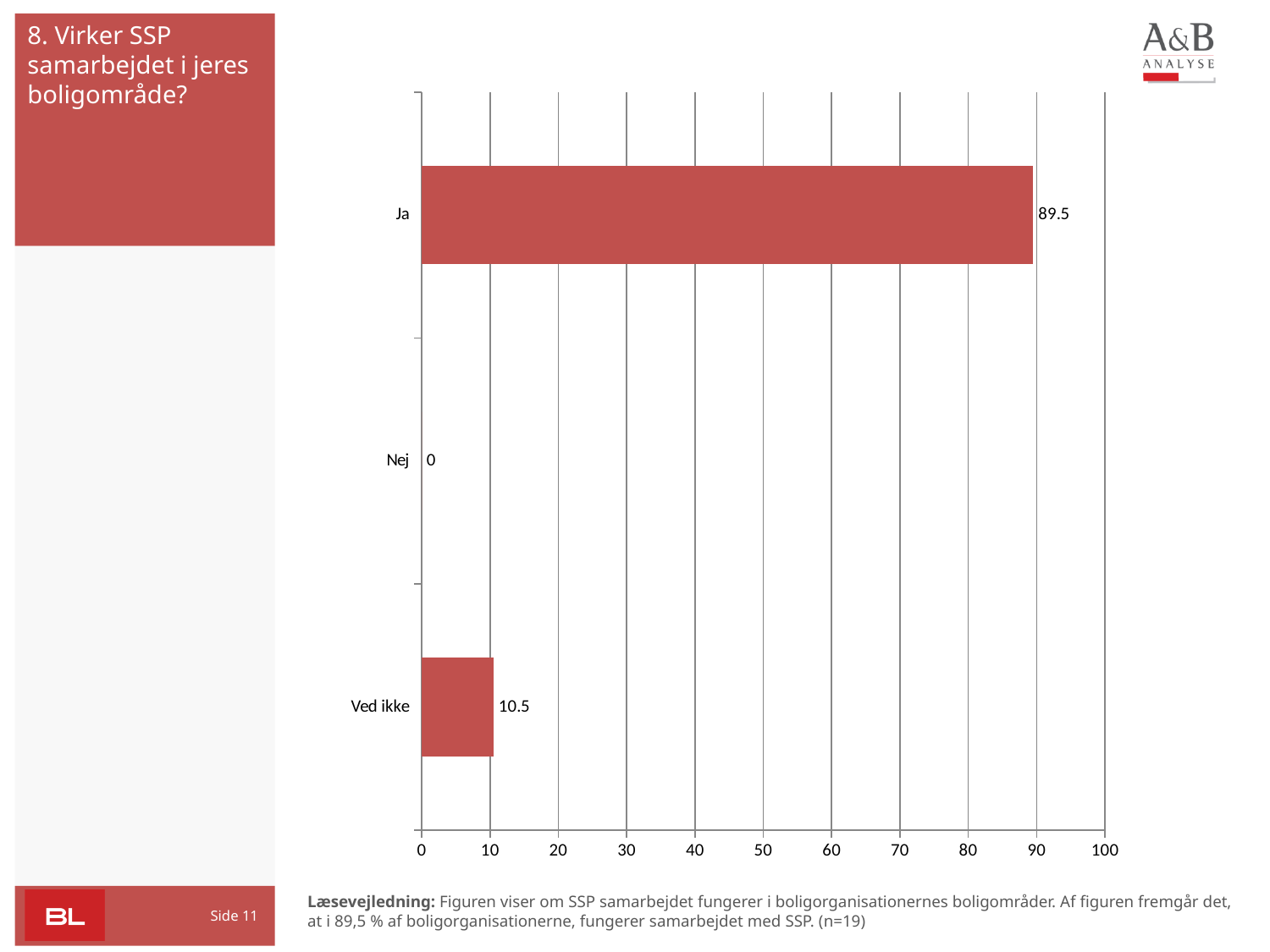
What is the value for "Ved ikke"? 10.5 Which is larger, the value for "Ved ikke" or the value for "Nej"? Ved ikke What is the value for "Ja"? 89.5 Which category has the lowest value? Nej Is the value for "Ja" greater or less than 80? greater What kind of chart is shown on the slide? bar chart Is the value for "Ved ikke" greater or less than 20? less What is the difference between the values for "Ja" and "Ved ikke"? 79 How many categories are shown in the chart? 3 Which category has the highest value? Ja What is the value for "Nej"? 0 What is the maximum value shown on the horizontal axis? 100